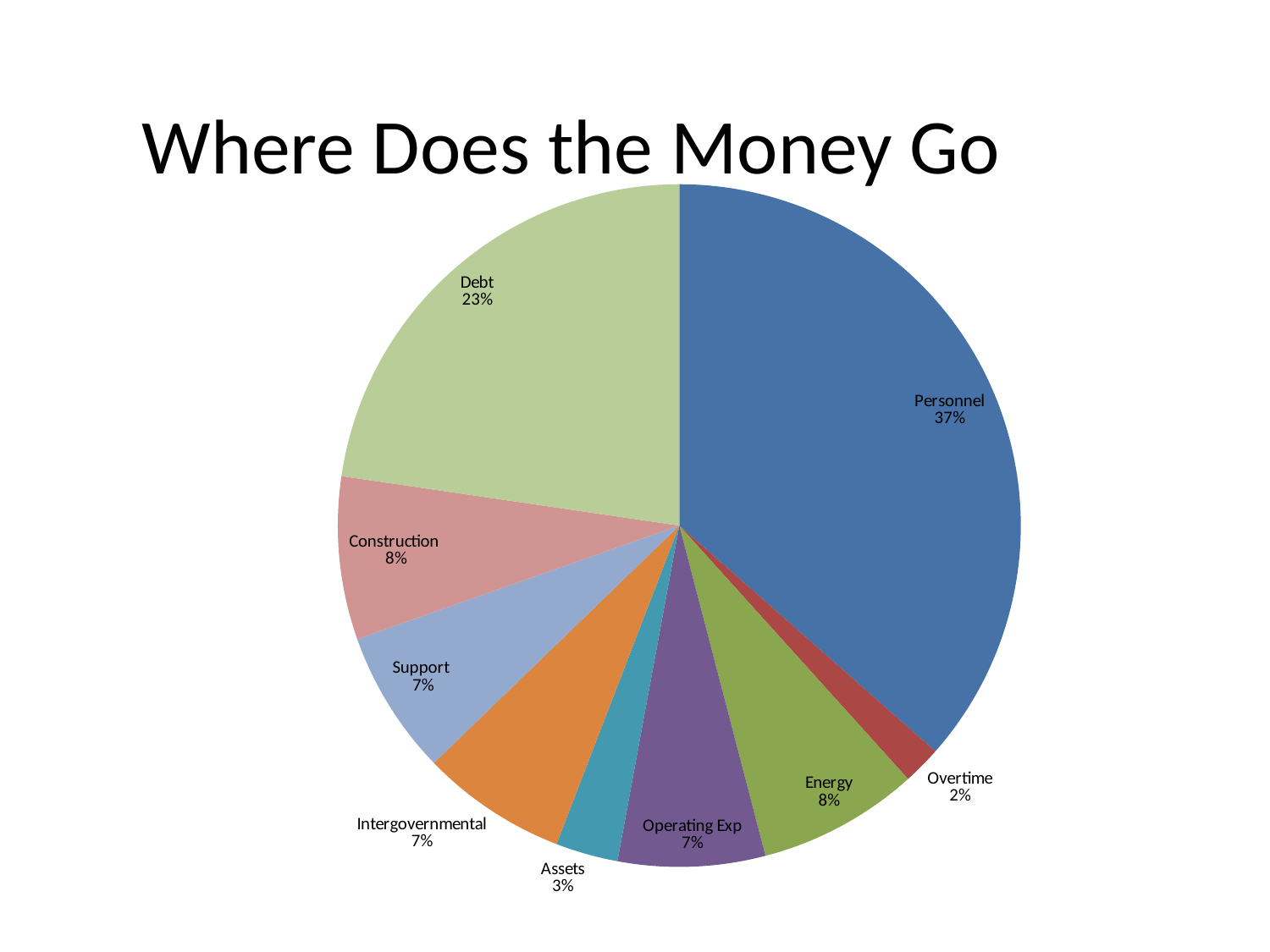
What share of the pie does Personnel account for? 37% What percentage is shown for Overtime? 2% What is the value shown for Debt? 23% Which category has the smallest slice of the pie? Overtime Which category has the largest slice of the pie? Personnel What is the title of the slide containing the chart? Where Does the Money Go What is the difference in percentage points between Personnel and Debt? 14 What kind of chart is shown on the slide? Pie chart What is the value shown for Intergovernmental? 7% Which is larger, Construction or Assets? Construction What is the difference in percentage points between Energy and Assets? 5 How many categories are shown in the pie chart? 9